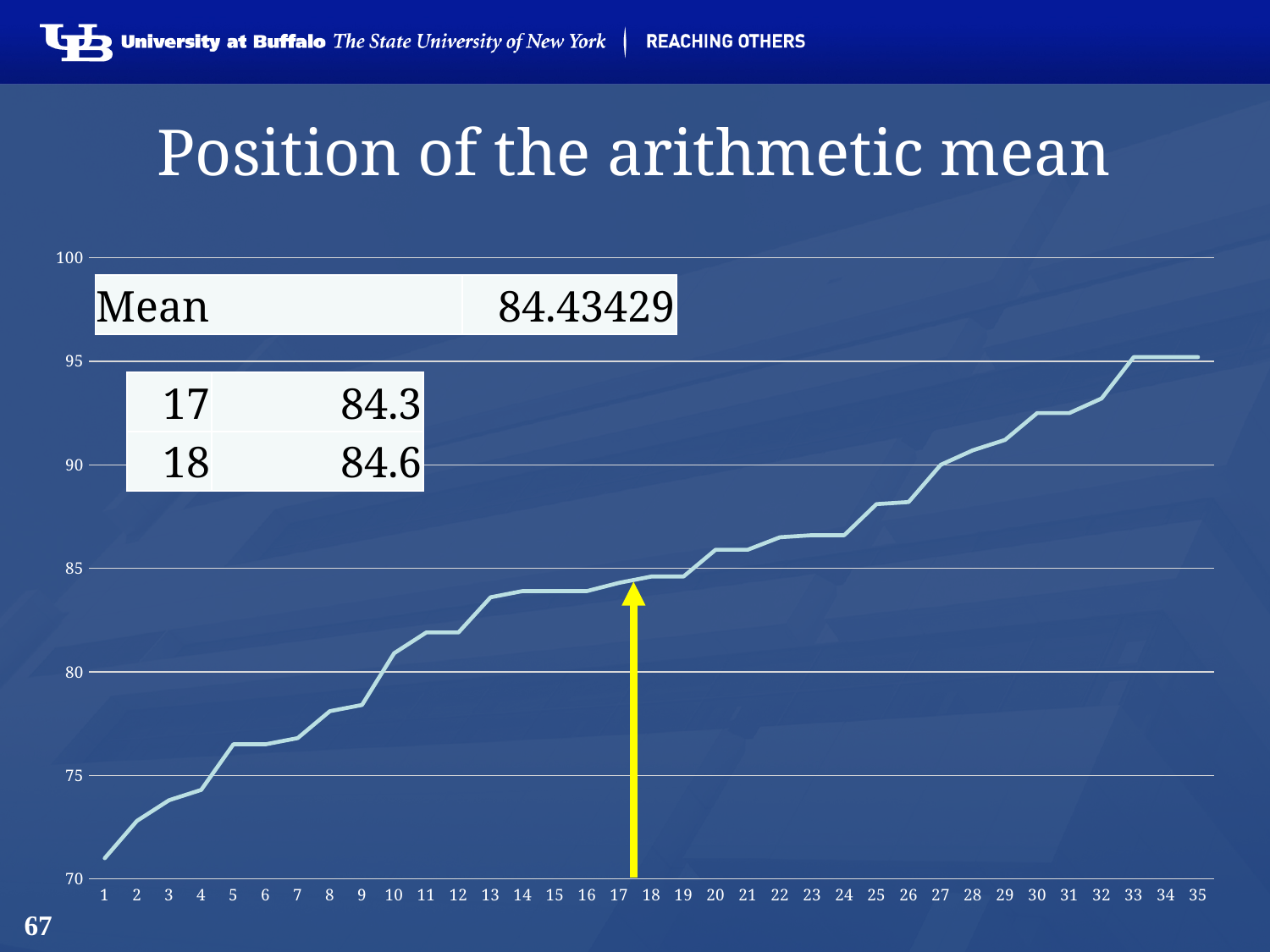
What mean value is shown on the slide? 84.43429 Which has the larger value, position 17 or position 18? 18 Is the value at position 25 greater or less than 85? greater Which position has the lowest value? 1 What is the value at position 17? 84.3 How many points are plotted along the x axis? 35 Do the plotted values rise or fall as the x axis goes from 1 to 35? rise Is the value at position 1 greater or less than 75? less What is the difference between the values at positions 18 and 17? 0.3 What kind of chart is shown on the slide? line chart What is the title of the chart? Position of the arithmetic mean What is the value at position 18? 84.6